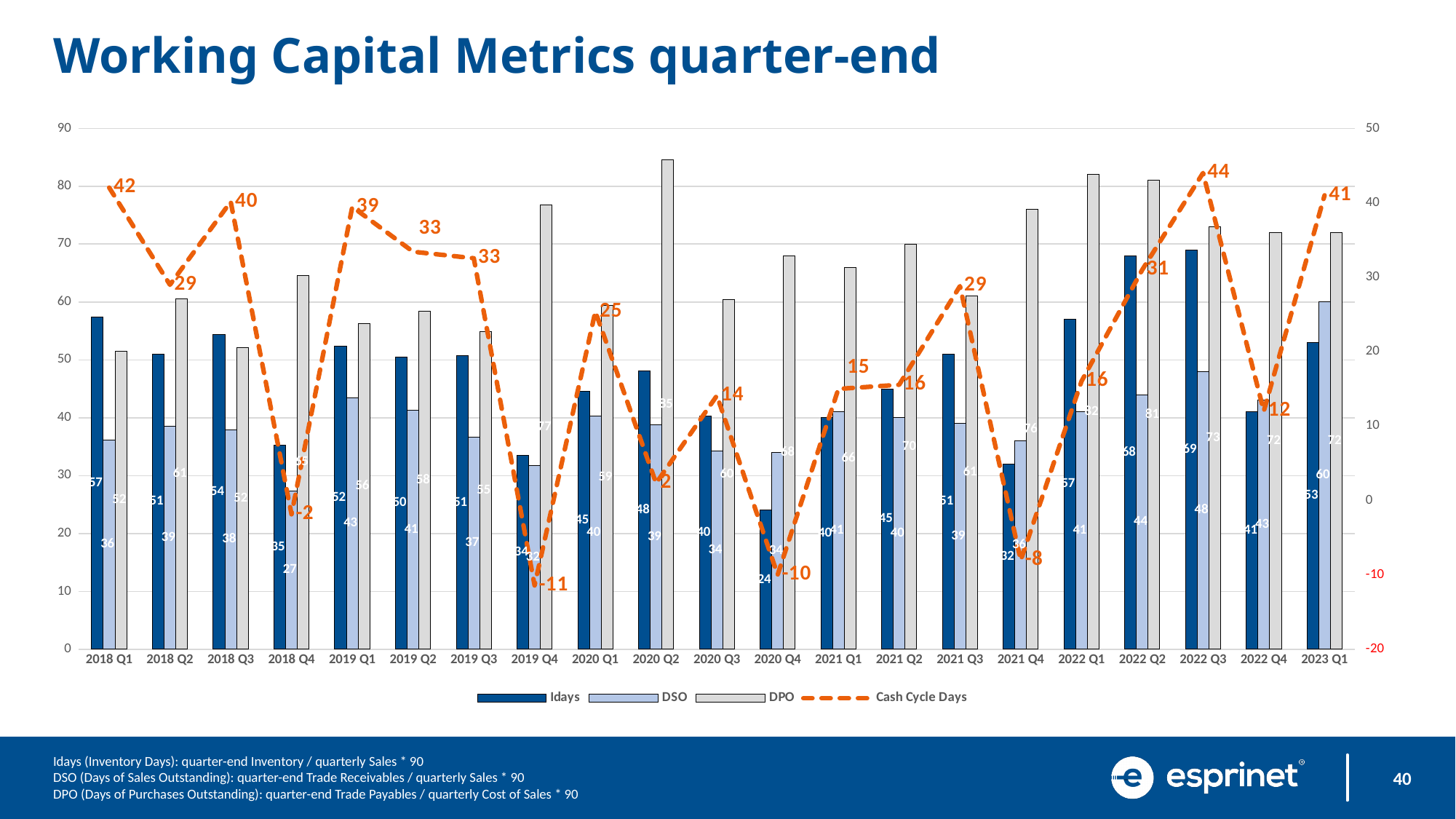
How many quarters are shown on the x axis? 21 Is the DPO value for 2019 Q4 greater or less than 70? greater Which is larger in 2018 Q1, Idays or DSO? Idays What kind of chart is shown on the slide? Combination bar and line chart Which series is plotted as a dashed line? Cash Cycle Days What is the Cash Cycle Days value for 2023 Q1? 41 In which quarter is Cash Cycle Days highest? 2022 Q3 How many series does the legend list? 4 What is the Idays value for 2020 Q4? 24 What is the DPO value for 2020 Q2? 85 What is the difference between Cash Cycle Days in 2022 Q3 and 2022 Q4? 32 In which quarter is Cash Cycle Days lowest? 2019 Q4